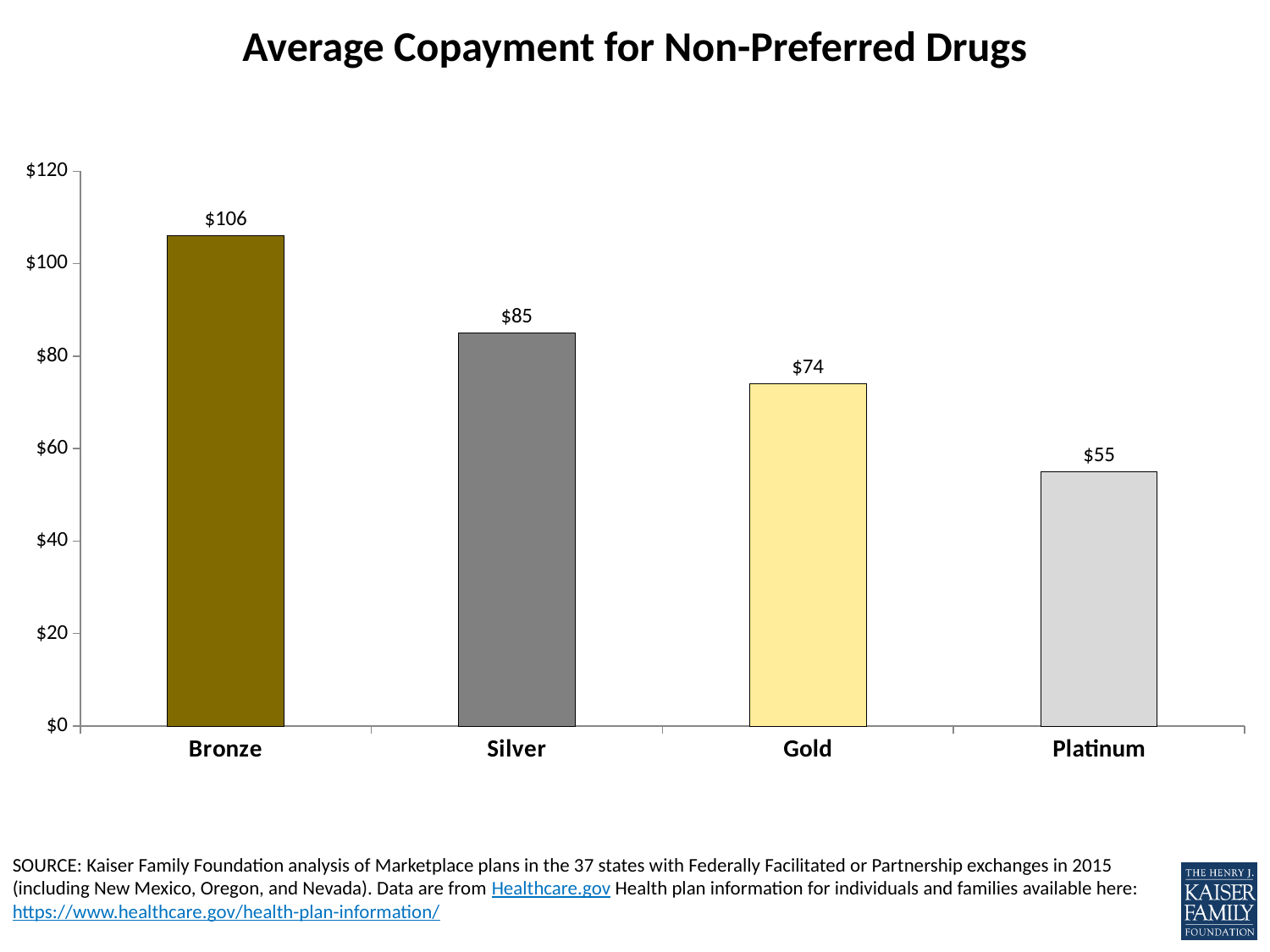
What kind of chart is shown on the slide? Bar chart What is the average copayment for non-preferred drugs for Platinum plans? $55 What is the difference between the average copayment for Silver and Gold plans? $11 Which plan type has the lowest average copayment for non-preferred drugs? Platinum What is the average copayment for non-preferred drugs for Gold plans? $74 What is the average copayment for non-preferred drugs for Bronze plans? $106 Which has a higher average copayment for non-preferred drugs, Silver or Gold? Silver Which plan type has the highest average copayment for non-preferred drugs? Bronze How many plan types are shown on the chart? 4 What is the average copayment for non-preferred drugs for Silver plans? $85 What is the difference between the average copayment for Bronze and Platinum plans? $51 Do the average copayments rise or fall moving from Bronze to Platinum along the x axis? Fall